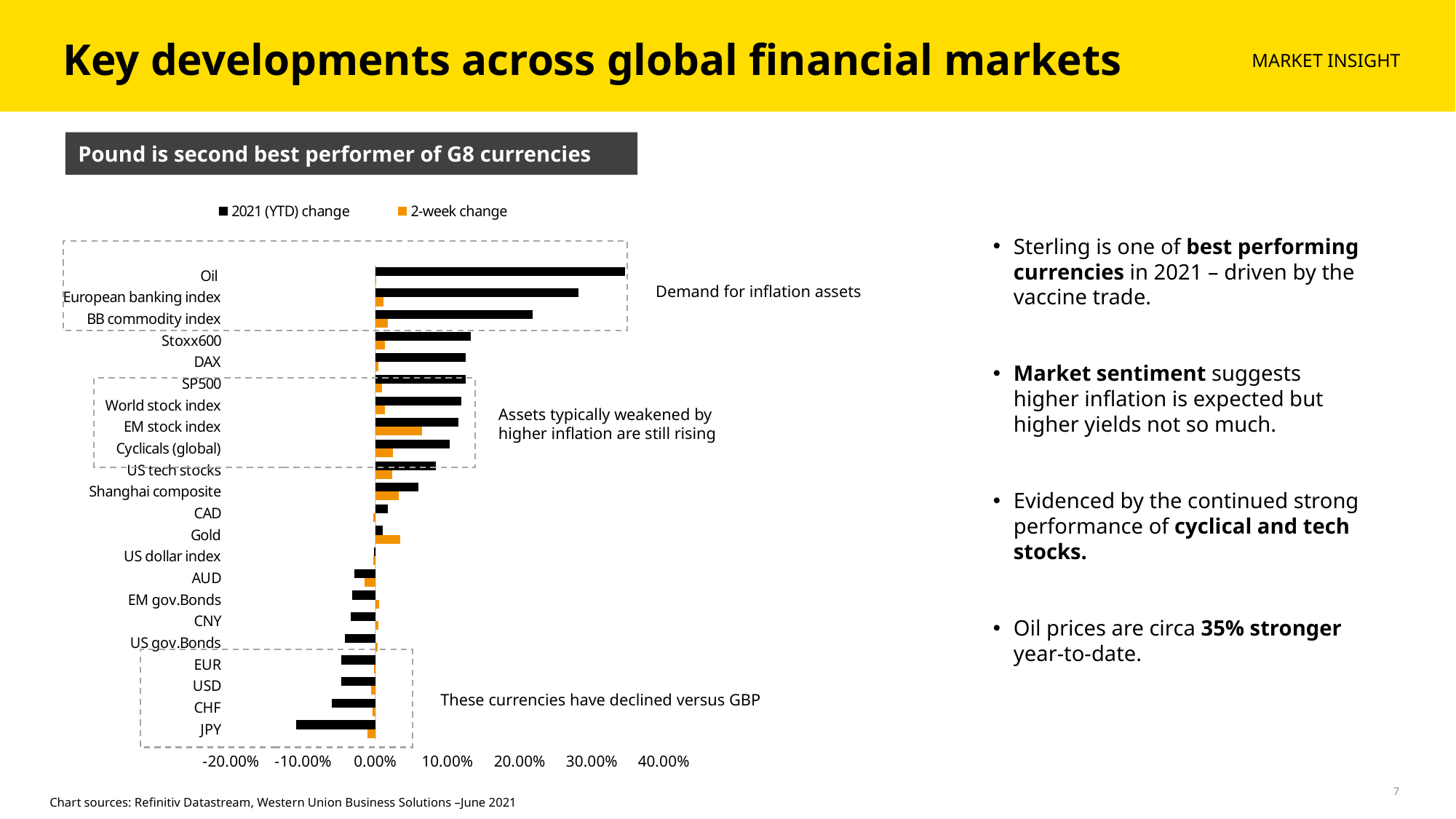
Which category has the lowest 2021 (YTD) change? JPY Is the 2021 (YTD) change for European banking index greater or less than 20.00%? greater Which has the lower 2021 (YTD) change, JPY or CHF? JPY Which category has the largest 2-week change? EM stock index Which category has the highest 2021 (YTD) change? Oil How many series does the chart legend list? 2 Is the 2021 (YTD) change for Oil greater or less than 30.00%? greater What kind of chart is shown on the slide? Bar chart What is the title of the chart? Pound is second best performer of G8 currencies Is the 2021 (YTD) change for CHF greater or less than 0.00%? less Which has the larger 2021 (YTD) change, Oil or European banking index? Oil How many categories are plotted on the chart? 22